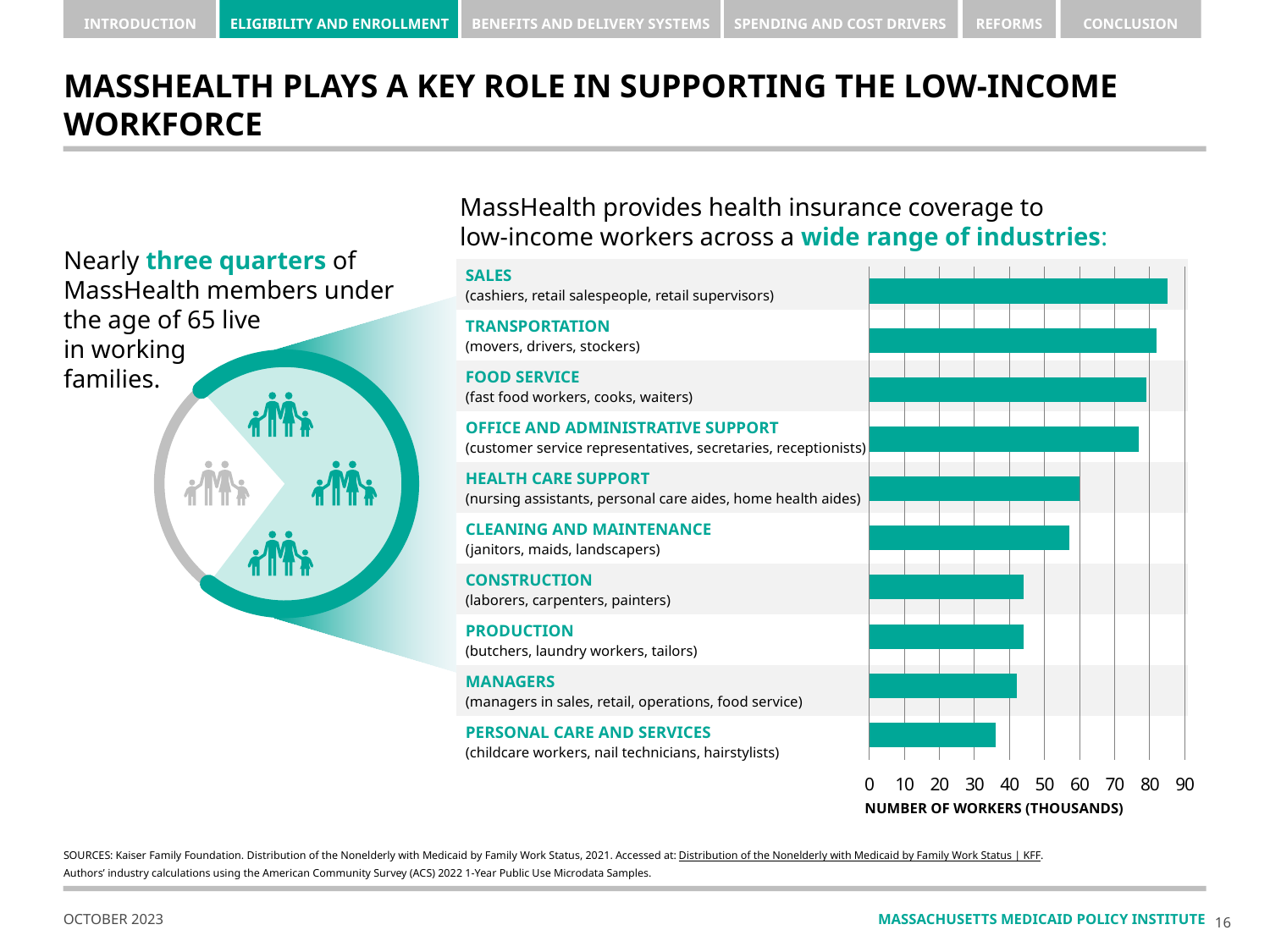
Is the value for Sales greater or less than 80? greater Is the value for Office and Administrative Support greater or less than 70? greater How many industries are plotted in the bar chart? 10 Is the value for Personal Care and Services greater or less than 40? less Which has more workers, Food Service or Cleaning and Maintenance? Food Service What kind of chart is shown on the right side of the slide? bar chart Which industry has the lowest number of workers in the bar chart? Personal Care and Services What is the title of the horizontal axis of the bar chart? NUMBER OF WORKERS (THOUSANDS) Which industry has the highest number of workers in the bar chart? Sales Which has more workers, Health Care Support or Construction? Health Care Support